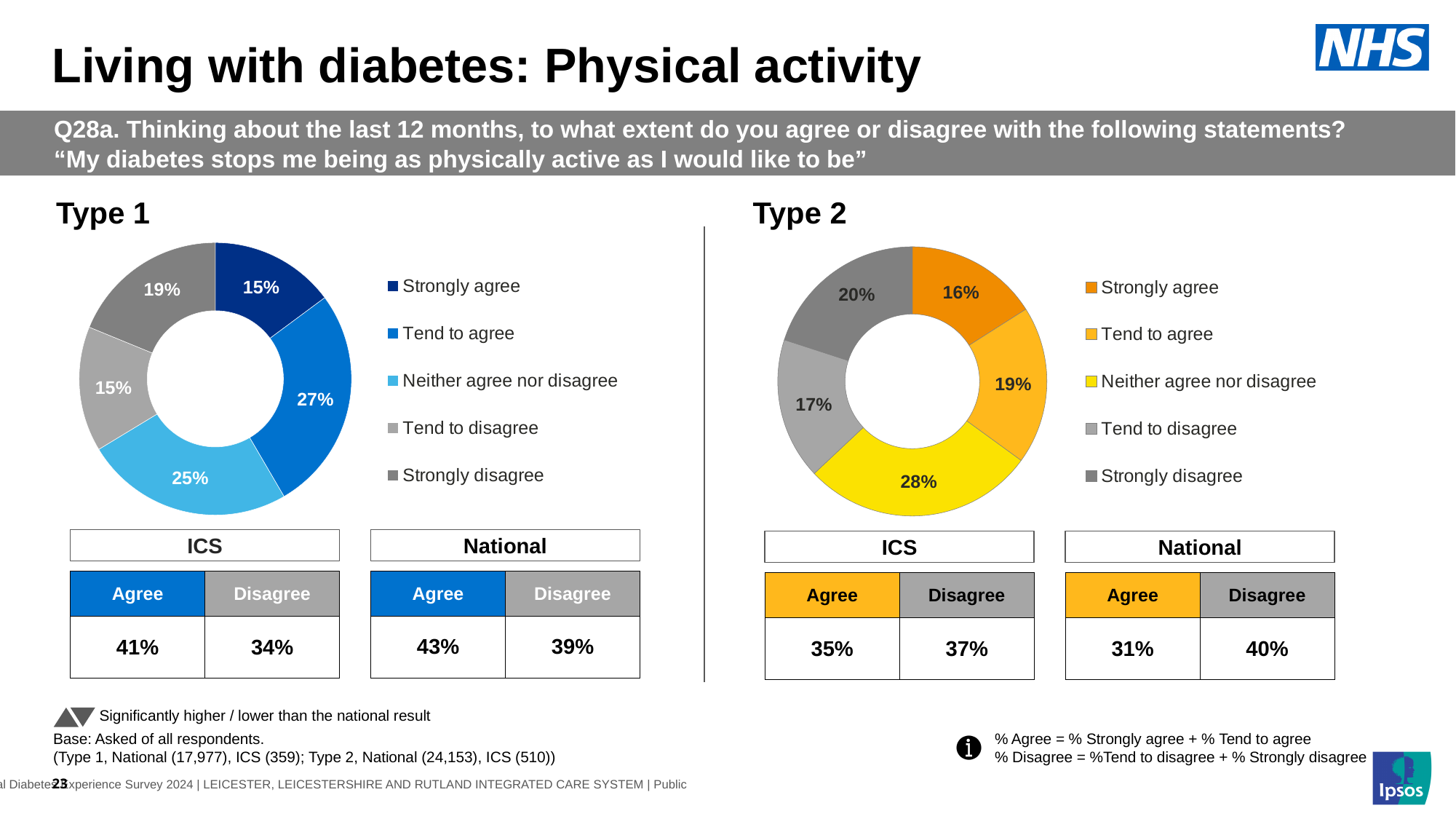
In the Type 1 chart, what percentage of respondents said 'Tend to agree'? 27% How many response categories are shown in the Type 1 chart? 5 In the Type 1 chart, what is the combined share of 'Strongly agree' and 'Tend to agree'? 42% In the Type 2 chart, what is the difference in percentage points between 'Neither agree nor disagree' and 'Tend to agree'? 9 percentage points In the Type 1 chart, which is larger: 'Neither agree nor disagree' or 'Strongly disagree'? Neither agree nor disagree What colour represents 'Neither agree nor disagree' in the Type 2 chart? Yellow In the Type 2 chart, what percentage of respondents said 'Tend to disagree'? 17% What type of chart is used for the Type 2 data? Donut (pie) chart In the Type 2 chart, which response category has the smallest share? Strongly agree In the Type 1 chart, which response category has the largest share? Tend to agree In the Type 2 chart, what percentage of respondents said 'Neither agree nor disagree'? 28% In the Type 1 chart, what percentage of respondents said 'Strongly disagree'? 19%